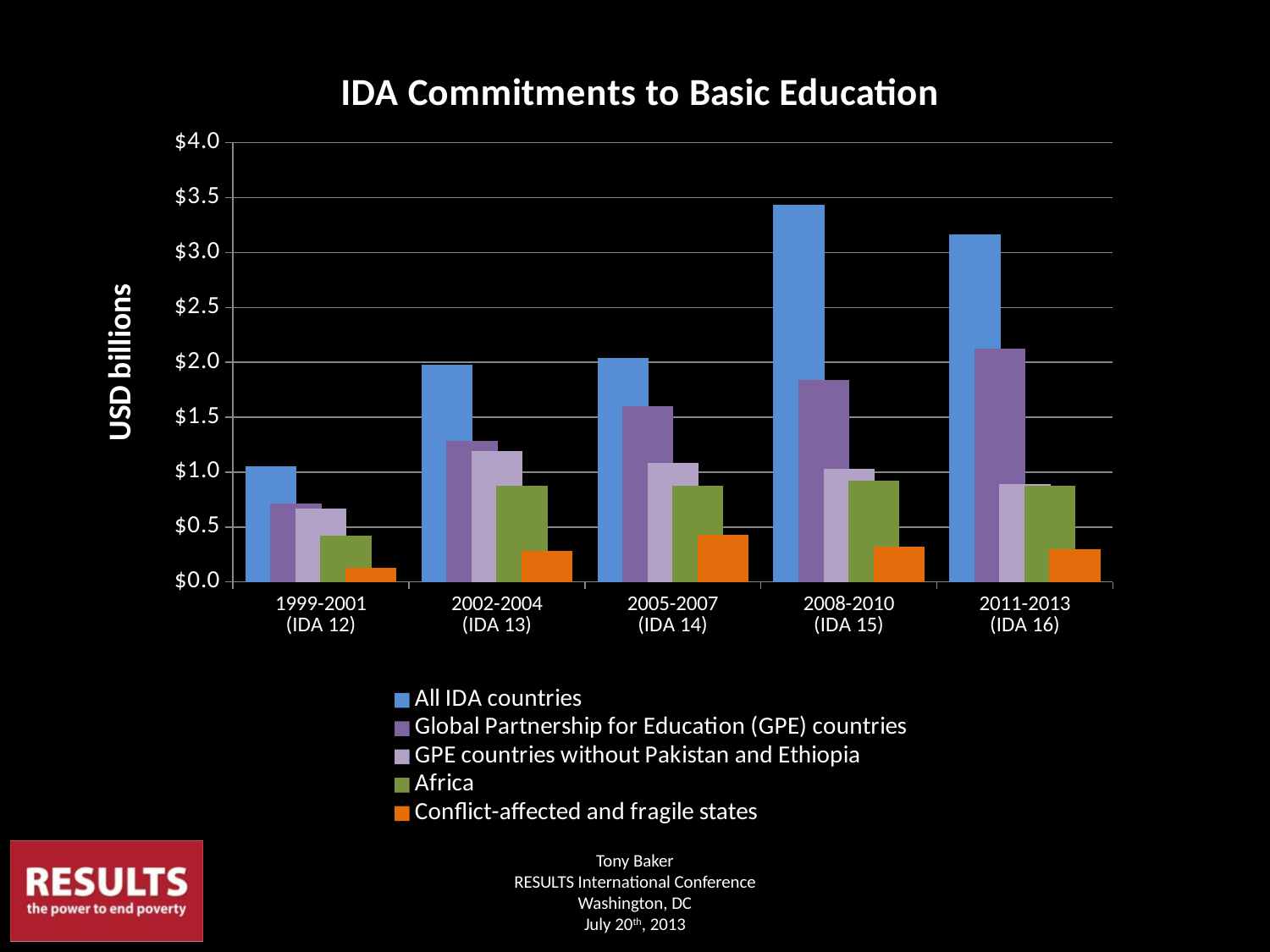
How many series does the legend list? 5 What is the label on the y axis of the chart? USD billions Which is larger for All IDA countries: the value in 2008-2010 (IDA 15) or in 2011-2013 (IDA 16)? 2008-2010 (IDA 15) In which period is the value for All IDA countries the highest? 2008-2010 (IDA 15) Is the value for Global Partnership for Education (GPE) countries in 2011-2013 (IDA 16) greater or less than $2.0? greater In which period is the value for Conflict-affected and fragile states the lowest? 1999-2001 (IDA 12) What kind of chart is shown on the slide? Bar chart Do the values for All IDA countries rise or fall from 1999-2001 (IDA 12) to 2008-2010 (IDA 15)? rise How many time periods are shown on the x axis? 5 Is the value for Conflict-affected and fragile states in 1999-2001 (IDA 12) greater or less than $0.5? less In which period is the value for Global Partnership for Education (GPE) countries the highest? 2011-2013 (IDA 16) Is the value for All IDA countries in 2008-2010 (IDA 15) greater or less than $3.0? greater